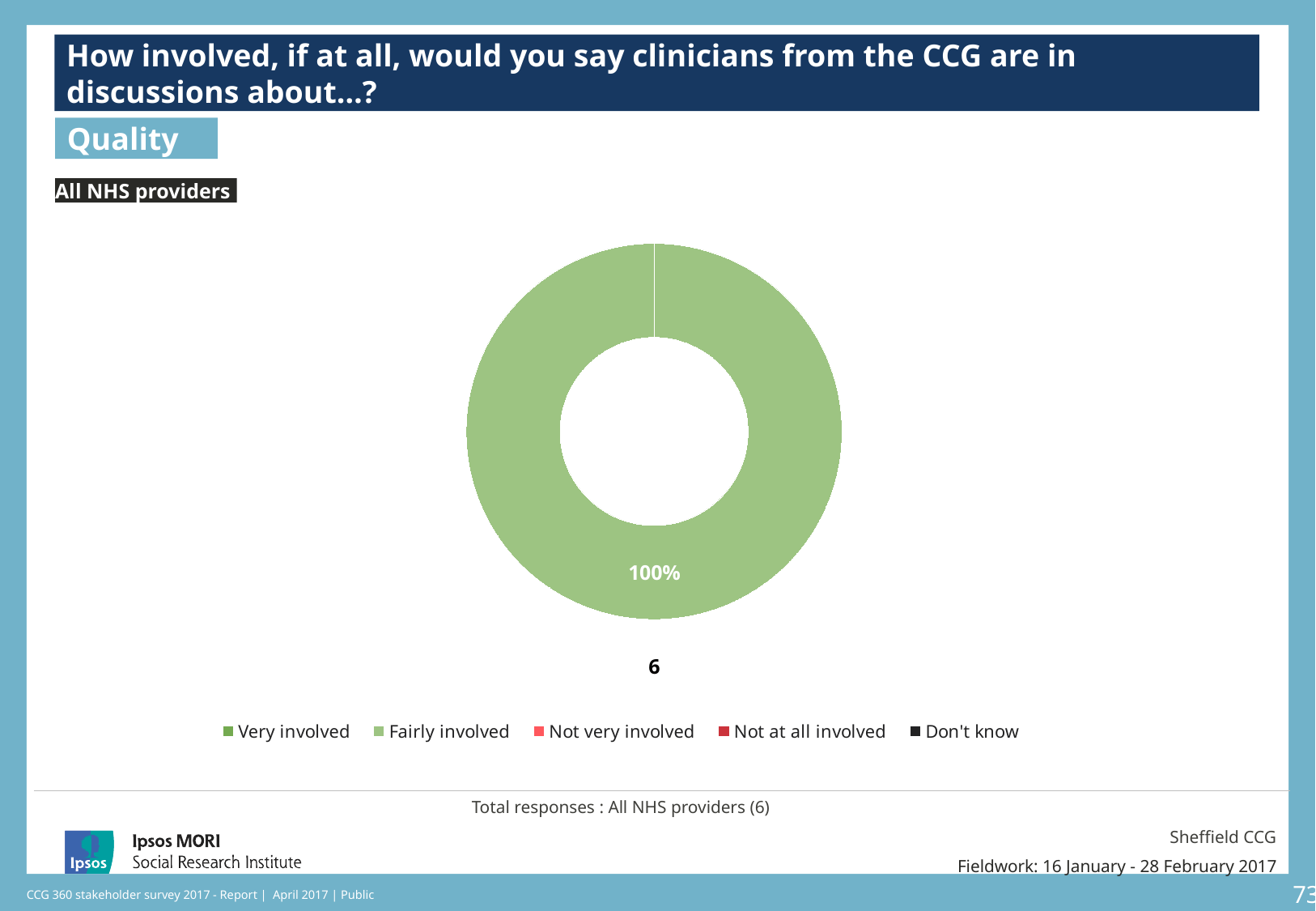
Is the value for 'Fairly involved' greater or less than 50%? greater What kind of chart is shown on the slide? doughnut (pie) chart What percentage is shown for 'Fairly involved' in the chart? 100% Which is larger in the chart, 'Fairly involved' or 'Very involved'? Fairly involved What share of the doughnut does the 'Fairly involved' slice take up? 100% Which response category makes up the largest part of the chart? Fairly involved What number is printed directly below the doughnut chart? 6 How many entries does the chart legend list? 5 How many slices are visible in the doughnut chart? 1 What is the total number of responses stated for All NHS providers? 6